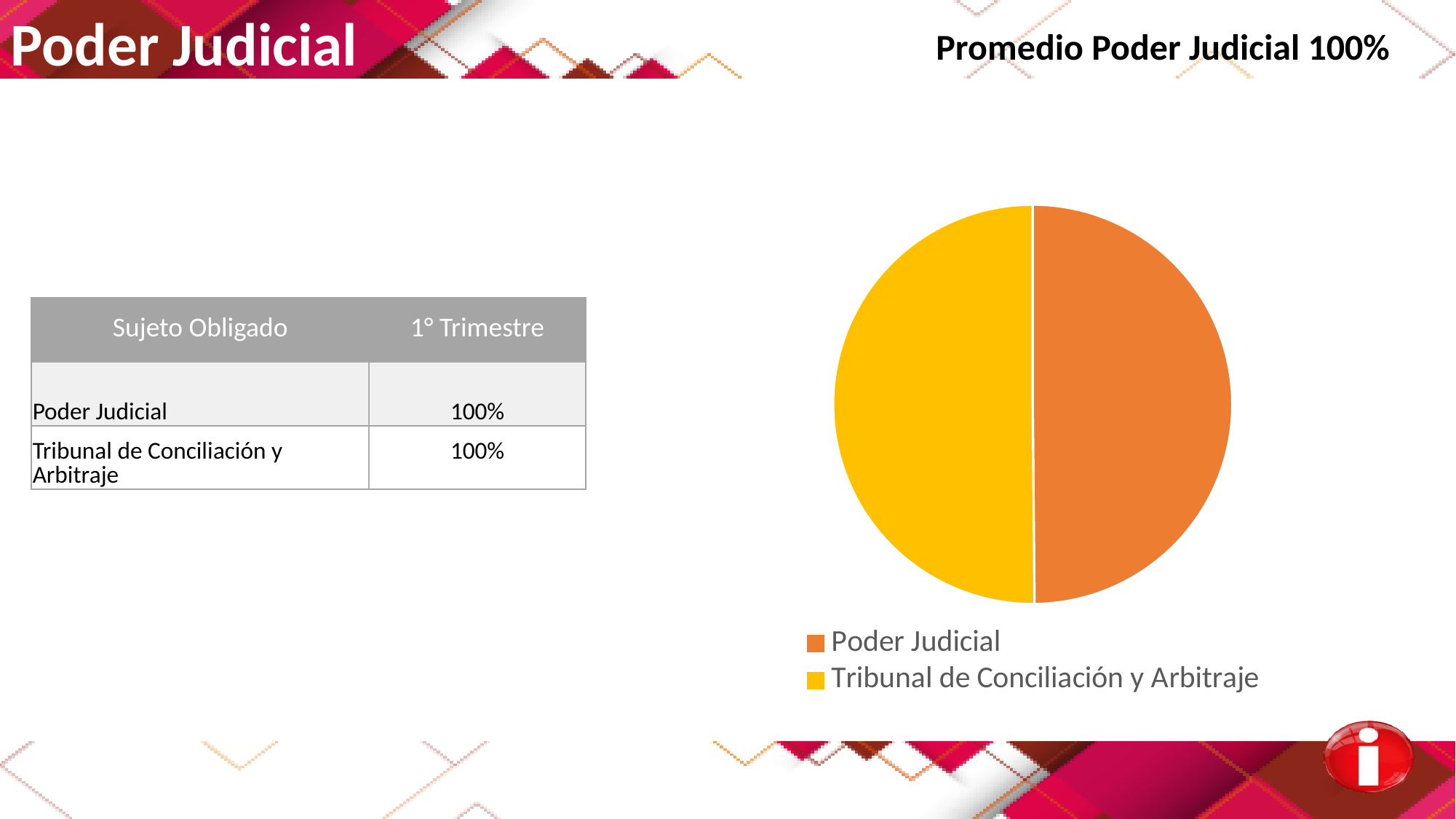
Which legend entry is shown in orange in the pie chart? Poder Judicial How many slices does the pie chart have? 2 According to the table, what is the 1° Trimestre value for Poder Judicial? 100% How many entries does the legend of the pie chart list? 2 What is the Promedio Poder Judicial value stated at the top of the slide? 100% What kind of chart is shown on the slide? pie chart According to the table, what is the 1° Trimestre value for Tribunal de Conciliación y Arbitraje? 100% What is the difference between the 1° Trimestre values of Poder Judicial and Tribunal de Conciliación y Arbitraje in the table? 0% Which legend entry is shown in yellow in the pie chart? Tribunal de Conciliación y Arbitraje